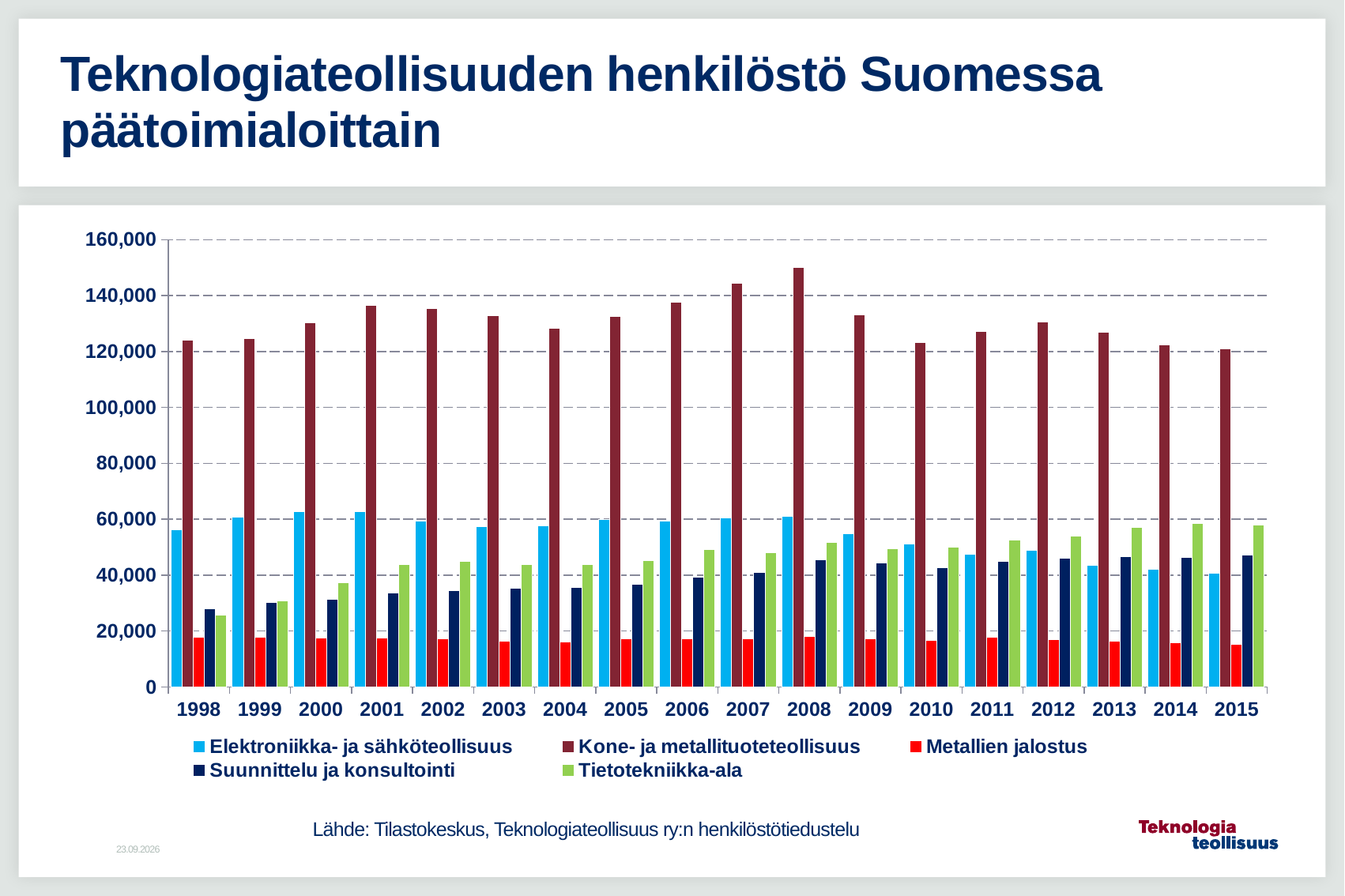
How many series does the legend list? 5 Which is larger in 2015: Tietotekniikka-ala or Elektroniikka- ja sähköteollisuus? Tietotekniikka-ala Is the value for Metallien jalostus in 2008 greater or less than 20,000? less In which year is the value for Suunnittelu ja konsultointi lowest? 1998 In which year is the value for Tietotekniikka-ala lowest? 1998 What kind of chart is shown on the slide? Bar chart In which year is the value for Kone- ja metallituoteteollisuus highest? 2008 Is the value for Elektroniikka- ja sähköteollisuus in 1998 greater or less than 60,000? less How many years are shown on the x axis? 18 Which is larger in 1998: Elektroniikka- ja sähköteollisuus or Tietotekniikka-ala? Elektroniikka- ja sähköteollisuus Does the value for Tietotekniikka-ala generally rise or fall from 1998 to 2015? Rise Is the value for Kone- ja metallituoteteollisuus in 2008 greater or less than 140,000? greater